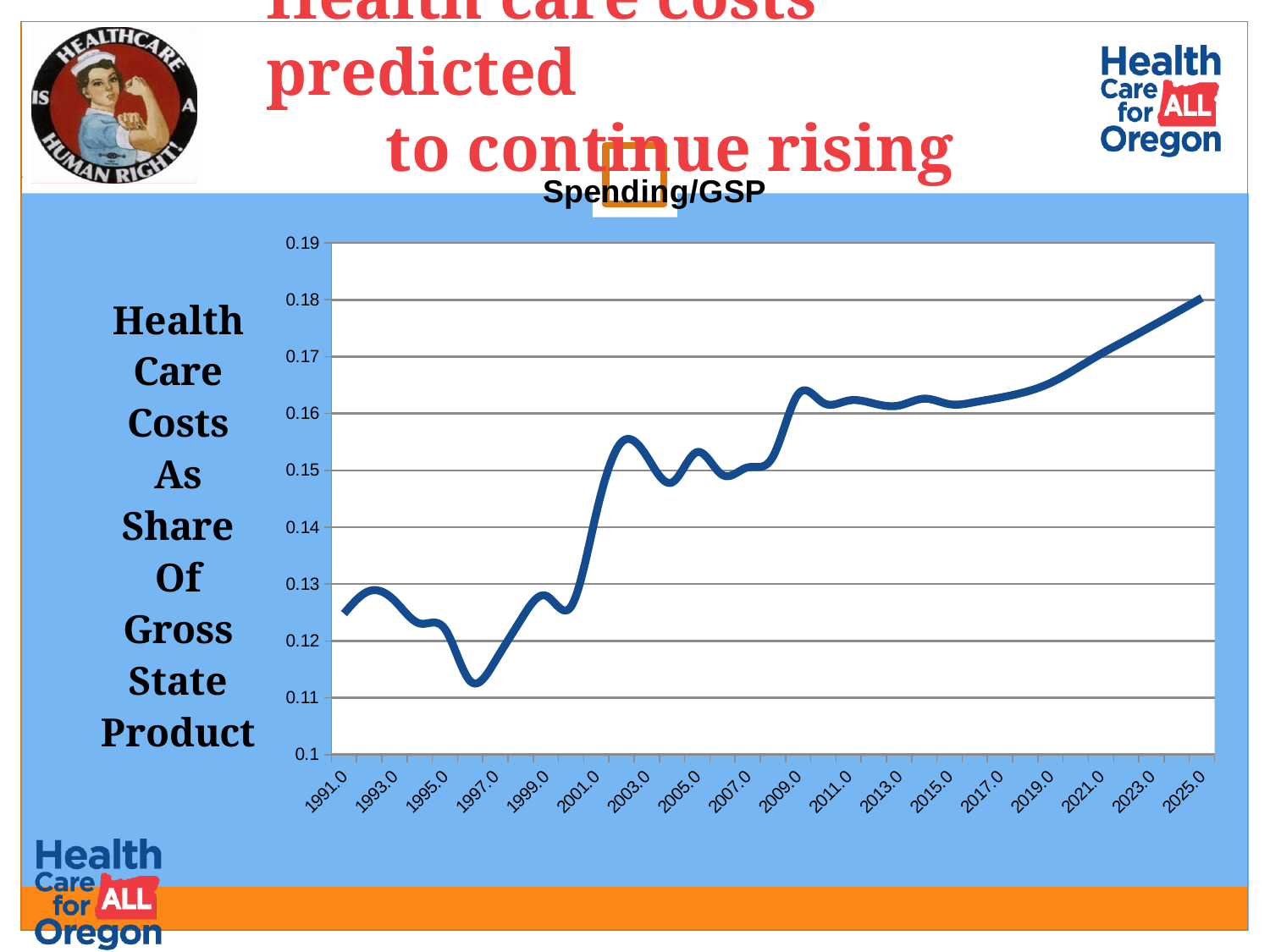
Is the value for 2009.0 greater or less than 0.16? greater In which labeled year does the line reach its lowest point? 1997.0 Is the value for 2025.0 greater or less than 0.17? greater Is the value for 1997.0 greater or less than 0.12? less What is the title of the chart? Spending/GSP How many year labels are shown on the x axis? 18 Overall, does the plotted value rise or fall from 1991.0 to 2025.0? rise In which labeled year does the line reach its highest point? 2025.0 What kind of chart is shown on the slide? line chart Which year has the larger value, 1995.0 or 2003.0? 2003.0